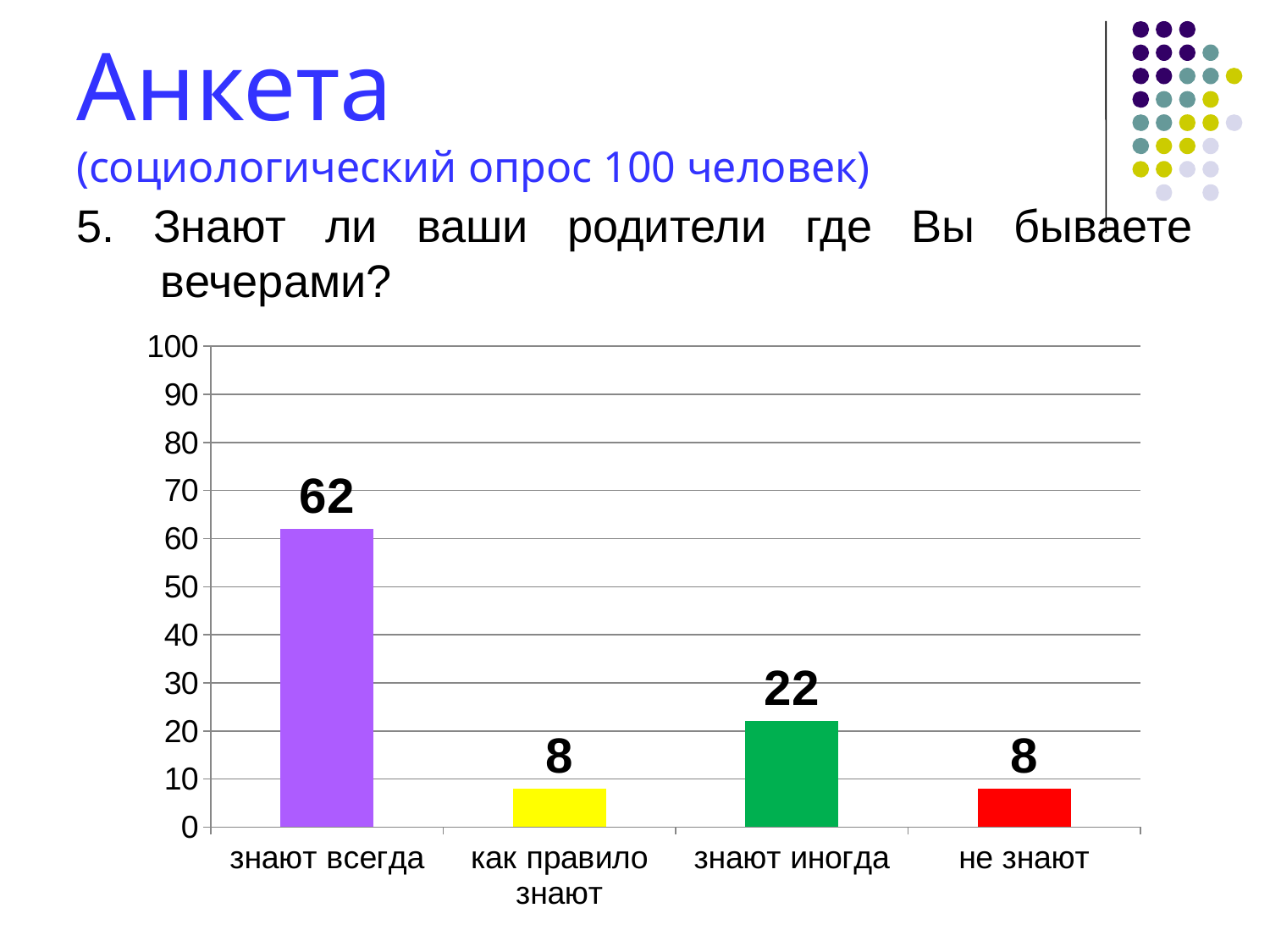
What colour is the bar for "знают иногда"? green What is the difference between the values for "знают иногда" and "не знают"? 14 What is the difference between the values for "знают всегда" and "знают иногда"? 40 How many categories are shown on the x axis? 4 What is the maximum value shown on the y axis? 100 Is the value for "знают всегда" greater or less than 50? greater What is the value for "знают иногда"? 22 What is the value for "не знают"? 8 Which is larger, the value for "знают иногда" or the value for "как правило знают"? знают иногда What kind of chart is shown on the slide? bar chart What is the value for "знают всегда"? 62 Which category has the highest value? знают всегда